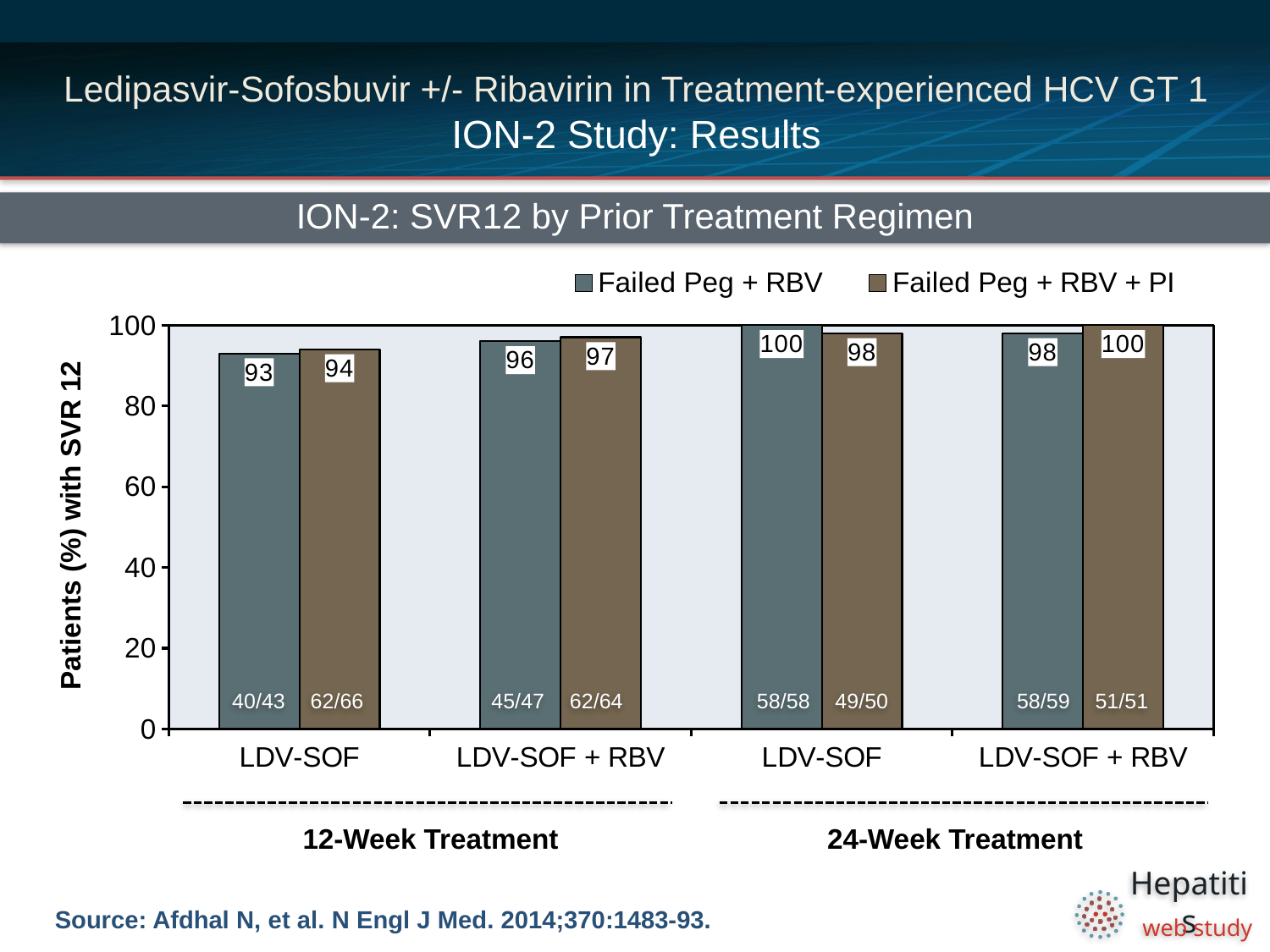
What is the SVR12 rate for the Failed Peg + RBV + PI group with 12-week LDV-SOF + RBV treatment? 97 How many treatment arm categories are shown on the x axis? 4 What patient fraction is shown for the Failed Peg + RBV + PI group with 12-week LDV-SOF treatment? 62/66 Which treatment arm has the lowest SVR12 rate for the Failed Peg + RBV group? 12-week LDV-SOF What kind of chart is shown on the slide? Bar chart What is the difference in SVR12 rate between the Failed Peg + RBV + PI group and the Failed Peg + RBV group for 12-week LDV-SOF + RBV treatment? 1 What is the SVR12 rate for the Failed Peg + RBV group with 24-week LDV-SOF treatment? 100 How many series does the legend list? 2 What is the title of the chart? ION-2: SVR12 by Prior Treatment Regimen For 24-week LDV-SOF treatment, which group has the higher SVR12 rate: Failed Peg + RBV or Failed Peg + RBV + PI? Failed Peg + RBV What is the SVR12 rate for the Failed Peg + RBV group with 12-week LDV-SOF treatment? 93 What is the SVR12 rate for the Failed Peg + RBV + PI group with 24-week LDV-SOF + RBV treatment? 100